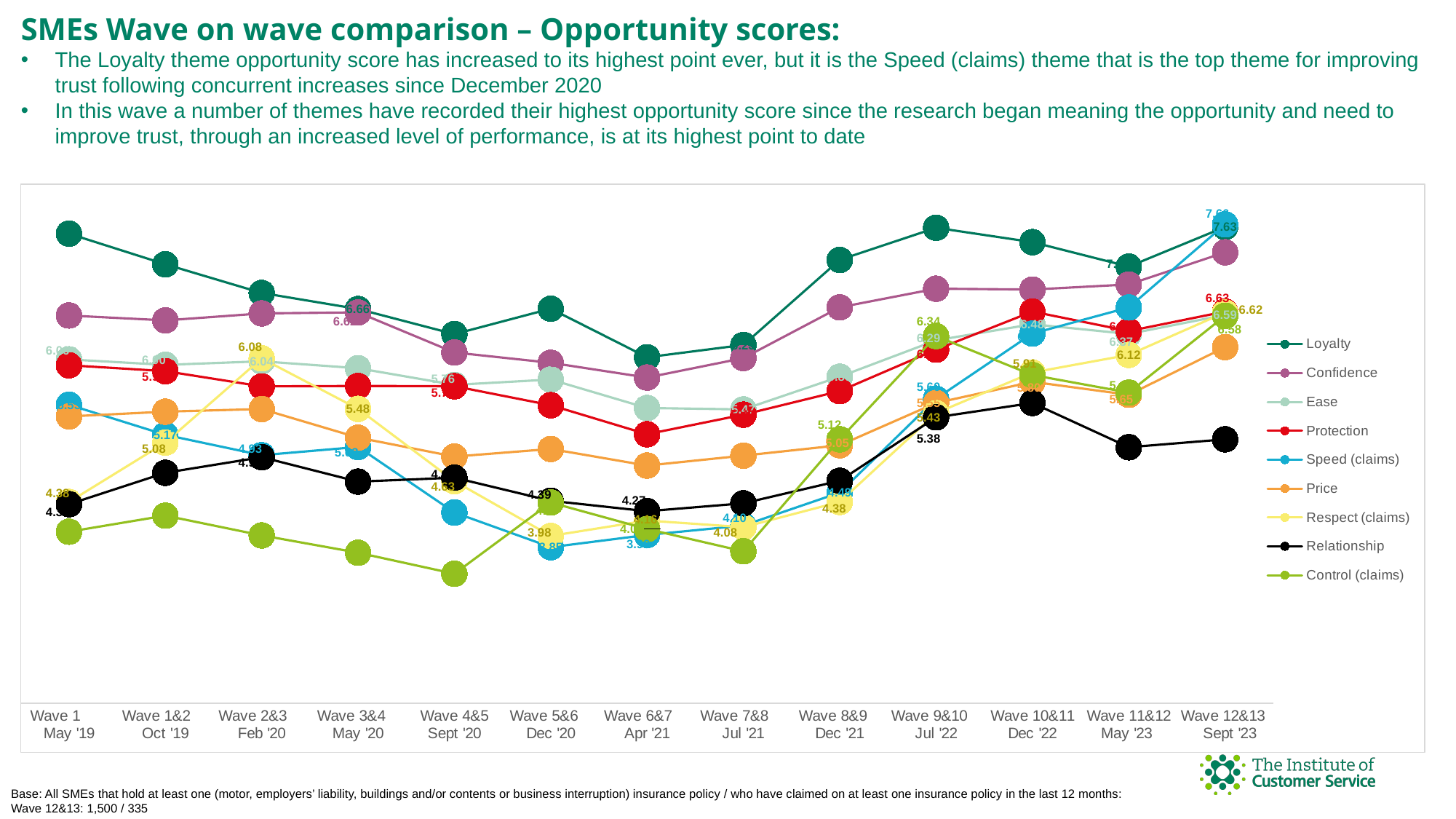
At Wave 12&13 (Sept '23), which is larger: the Price score or the Relationship score? Price Does the Loyalty score rise or fall from Wave 1 (May '19) to Wave 4&5 (Sept '20)? Fall How many series does the legend list? 9 What is the Respect (claims) opportunity score at Wave 2&3 (Feb '20)? 6.08 What is the Relationship opportunity score at Wave 6&7 (Apr '21)? 4.27 Which series is listed first in the legend? Loyalty Which theme has the highest opportunity score at Wave 1 (May '19)? Loyalty Which theme has the highest opportunity score at Wave 12&13 (Sept '23)? Speed (claims) What kind of chart is shown on the slide? Line chart What is the Control (claims) opportunity score at Wave 9&10 (Jul '22)? 6.34 How many waves are shown along the x axis? 13 Which theme has the lowest opportunity score at Wave 4&5 (Sept '20)? Control (claims)